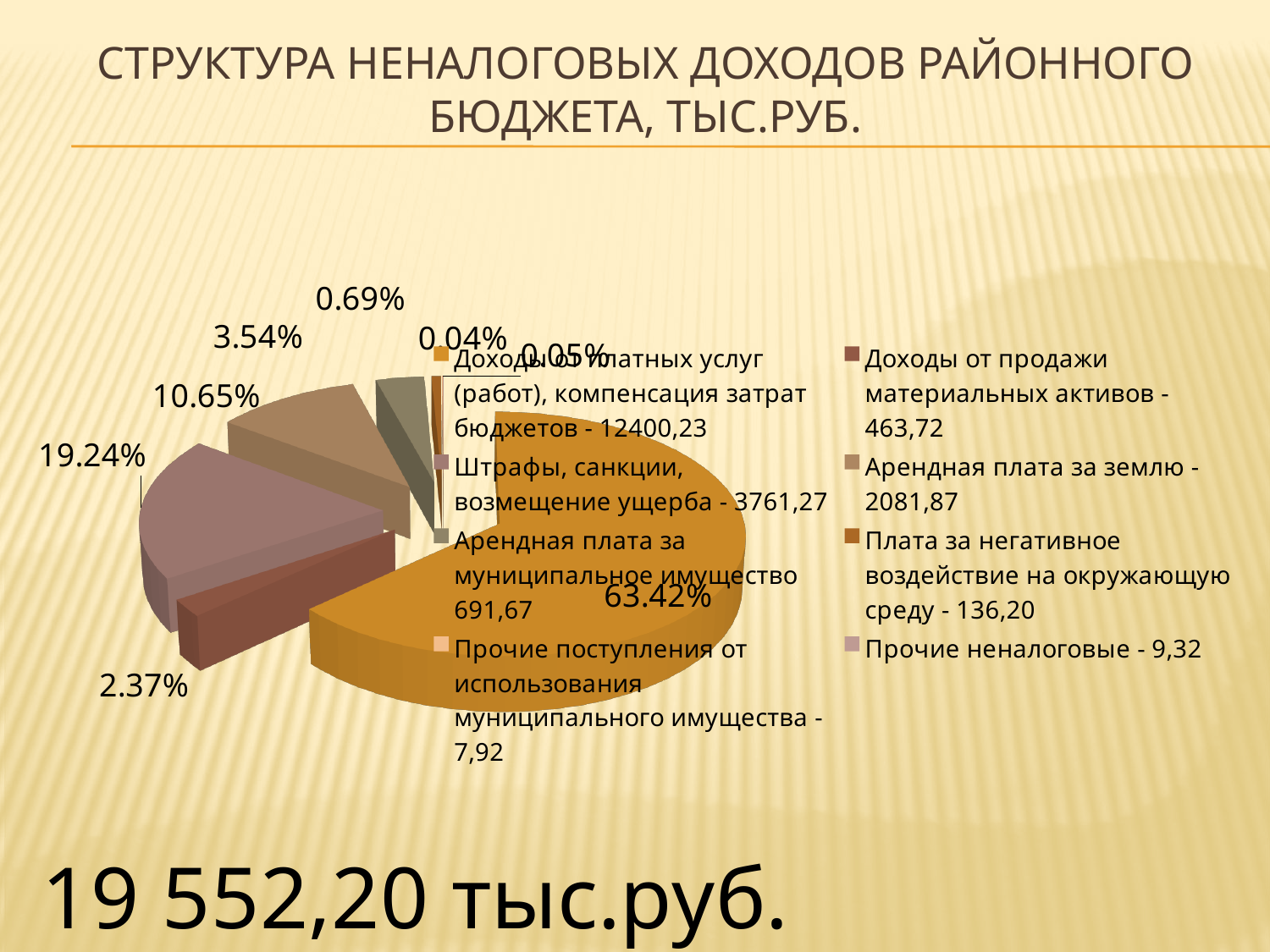
What is the difference between the values for Штрафы, санкции, возмещение ущерба and Арендная плата за землю? 1679,40 What value is given in the legend for Арендная плата за землю? 2081,87 What is the title of the chart on the slide? СТРУКТУРА НЕНАЛОГОВЫХ ДОХОДОВ РАЙОННОГО БЮДЖЕТА, ТЫС.РУБ. What total amount of non-tax revenue is stated on the slide? 19 552,20 тыс.руб. What share of the pie does the largest slice represent? 63.42% Which category has the largest share of the pie chart? Доходы от платных услуг (работ), компенсация затрат бюджетов How many categories does the legend of the pie chart list? 8 What value is given in the legend for Штрафы, санкции, возмещение ущерба? 3761,27 Which is larger: Доходы от продажи материальных активов or Арендная плата за муниципальное имущество? Арендная плата за муниципальное имущество What value is given in the legend for Плата за негативное воздействие на окружающую среду? 136,20 Which category has the smallest value in the legend? Прочие поступления от использования муниципального имущества What type of chart is shown on the slide? pie chart